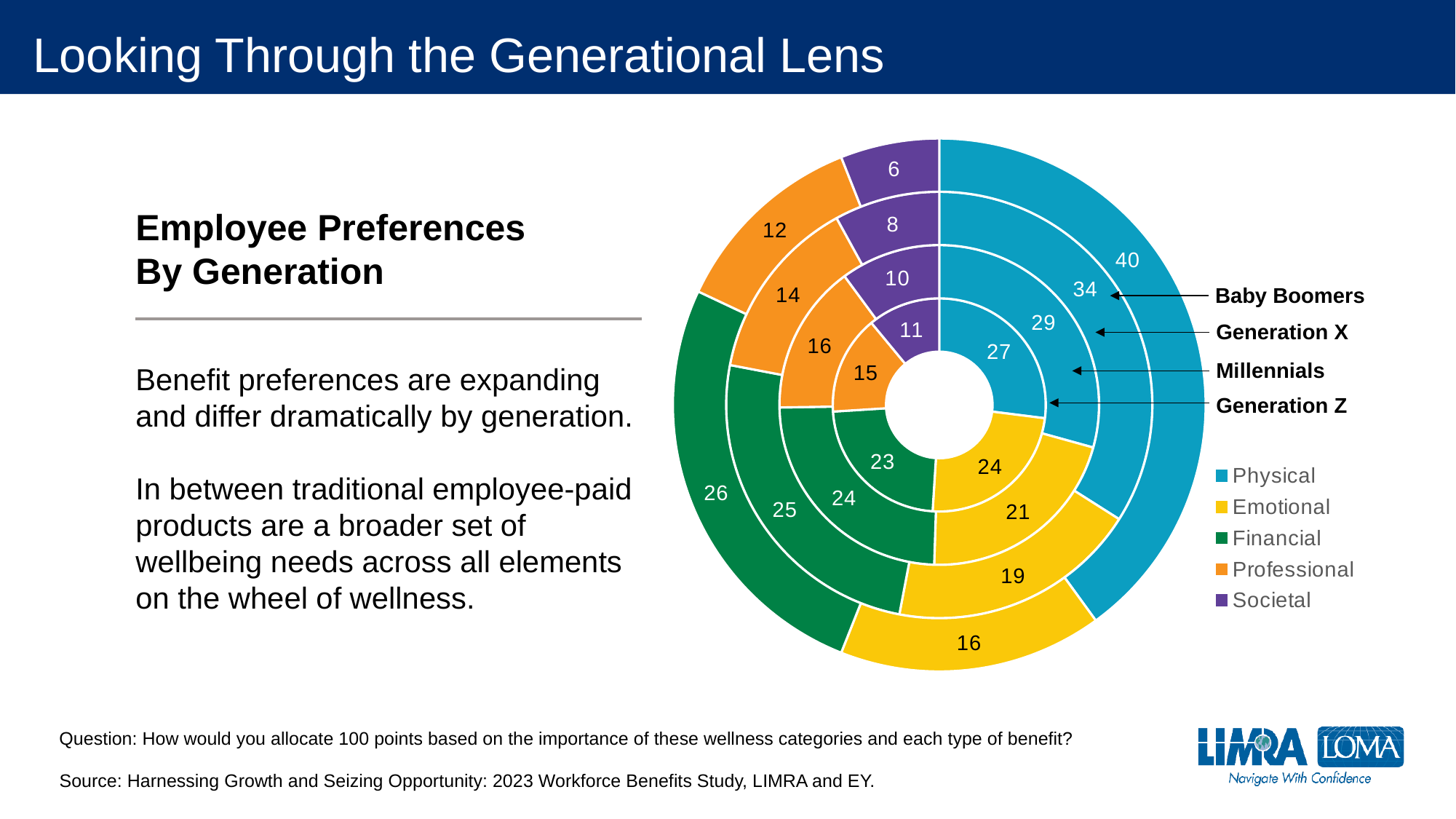
How many series does the legend list? 5 Which wellness category has the lowest value for Generation Z? Societal Which generation is represented by the outermost ring? Baby Boomers What is the Physical value for Baby Boomers? 40 How does the Societal value change from Baby Boomers to Generation Z? It rises Which wellness category has the highest value for Baby Boomers? Physical Which is larger for Generation Z: the Emotional value or the Financial value? Emotional What is the Emotional value for Millennials? 21 What kind of chart is shown on the slide? Doughnut chart What is the difference between the Physical values for Baby Boomers and Generation Z? 13 What is the Societal value for Generation Z? 11 What is the Professional value for Generation X? 14